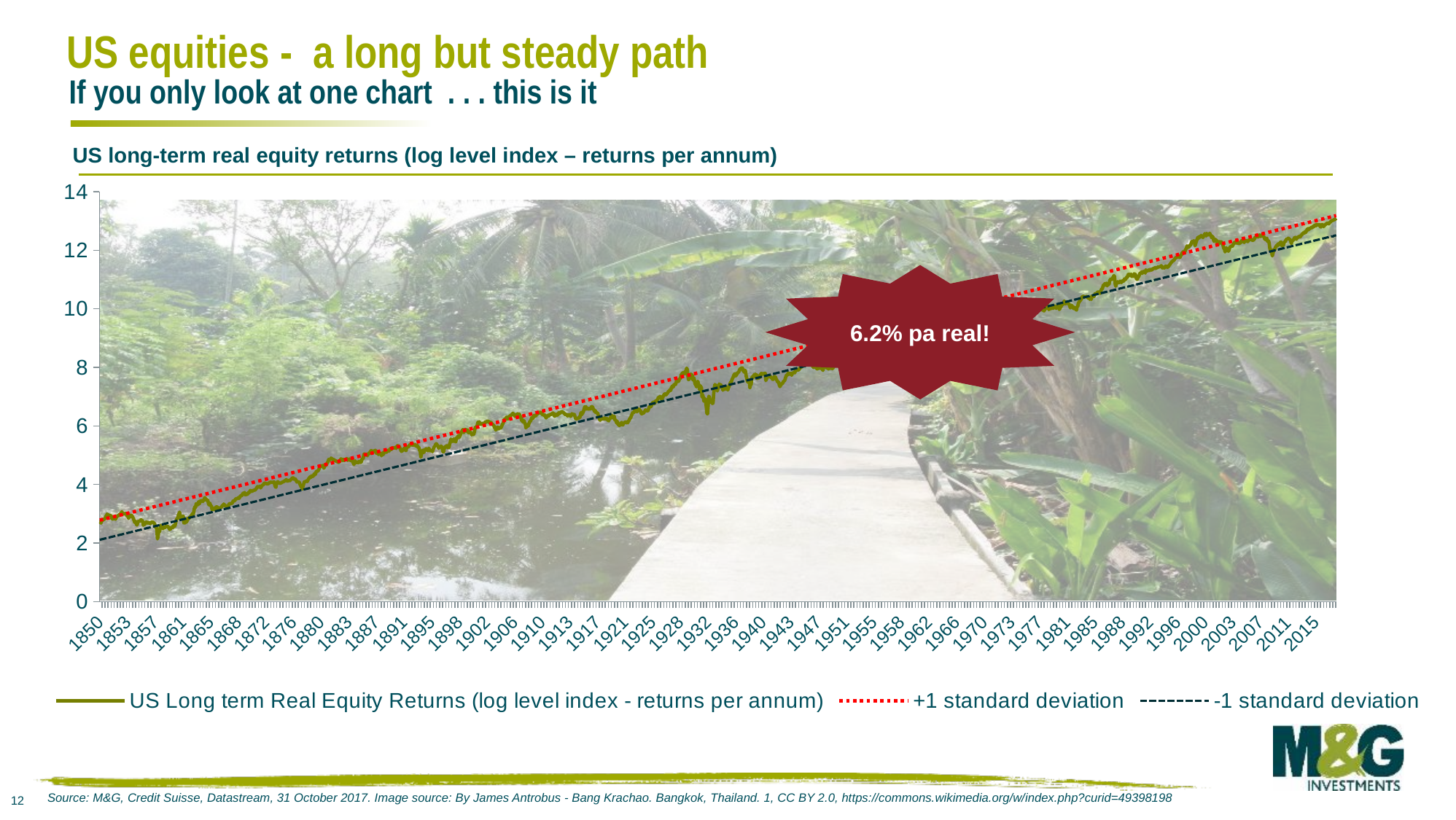
What is the title of the chart? US long-term real equity returns (log level index – returns per annum) What kind of chart is shown on the slide? line chart Is the value of the US Long term Real Equity Returns line in 1902 greater or less than 8? less Which series is drawn as a red dotted line? +1 standard deviation What annual real return is stated in the starburst annotation on the chart? 6.2% pa real! Is the value of the US Long term Real Equity Returns line in 1850 greater or less than 4? less Does the US Long term Real Equity Returns line rise or fall from 1850 to 2015? rise How many series does the legend list? 3 Is the value of the US Long term Real Equity Returns line in 2015 greater or less than 12? greater